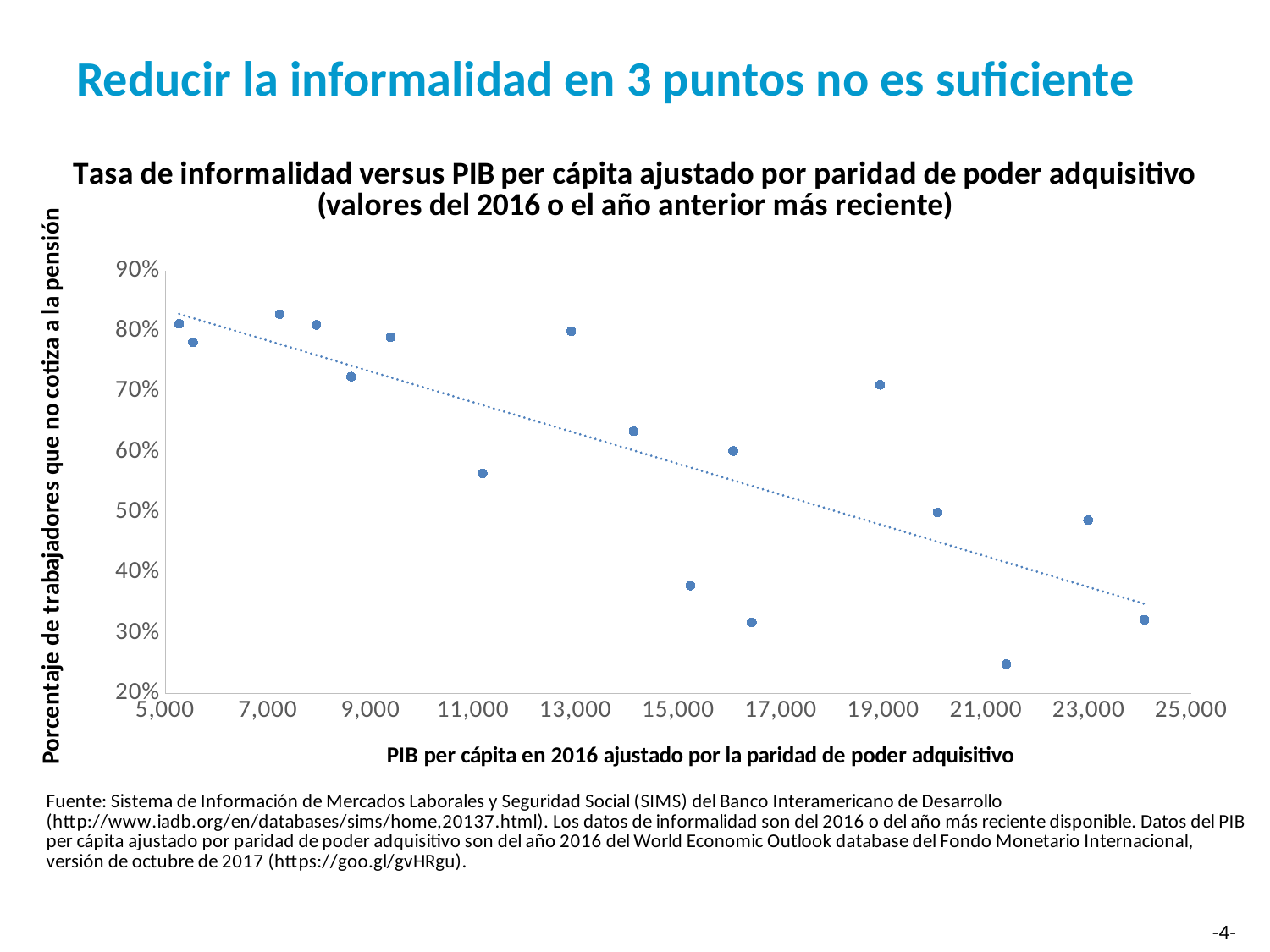
As PIB per cápita increases along the x axis, does the informality rate generally rise or fall? Fall Is the informality rate of the point with the lowest value on the chart greater or less than 30%? less Which is larger: the informality rate of the point near 13,000 PIB per cápita or the point near 14,000 PIB per cápita? The point near 13,000 Is the informality rate of the point with the highest PIB per cápita (around 24,000) greater or less than 40%? less Is the informality rate of the point at roughly 19,000 PIB per cápita greater or less than 60%? greater What is the label of the x axis? PIB per cápita en 2016 ajustado por la paridad de poder adquisitivo What kind of chart is shown on the slide? Scatter plot How many data points are plotted in the scatter chart? 17 What is the title of the chart? Tasa de informalidad versus PIB per cápita ajustado por paridad de poder adquisitivo (valores del 2016 o el año anterior más reciente)